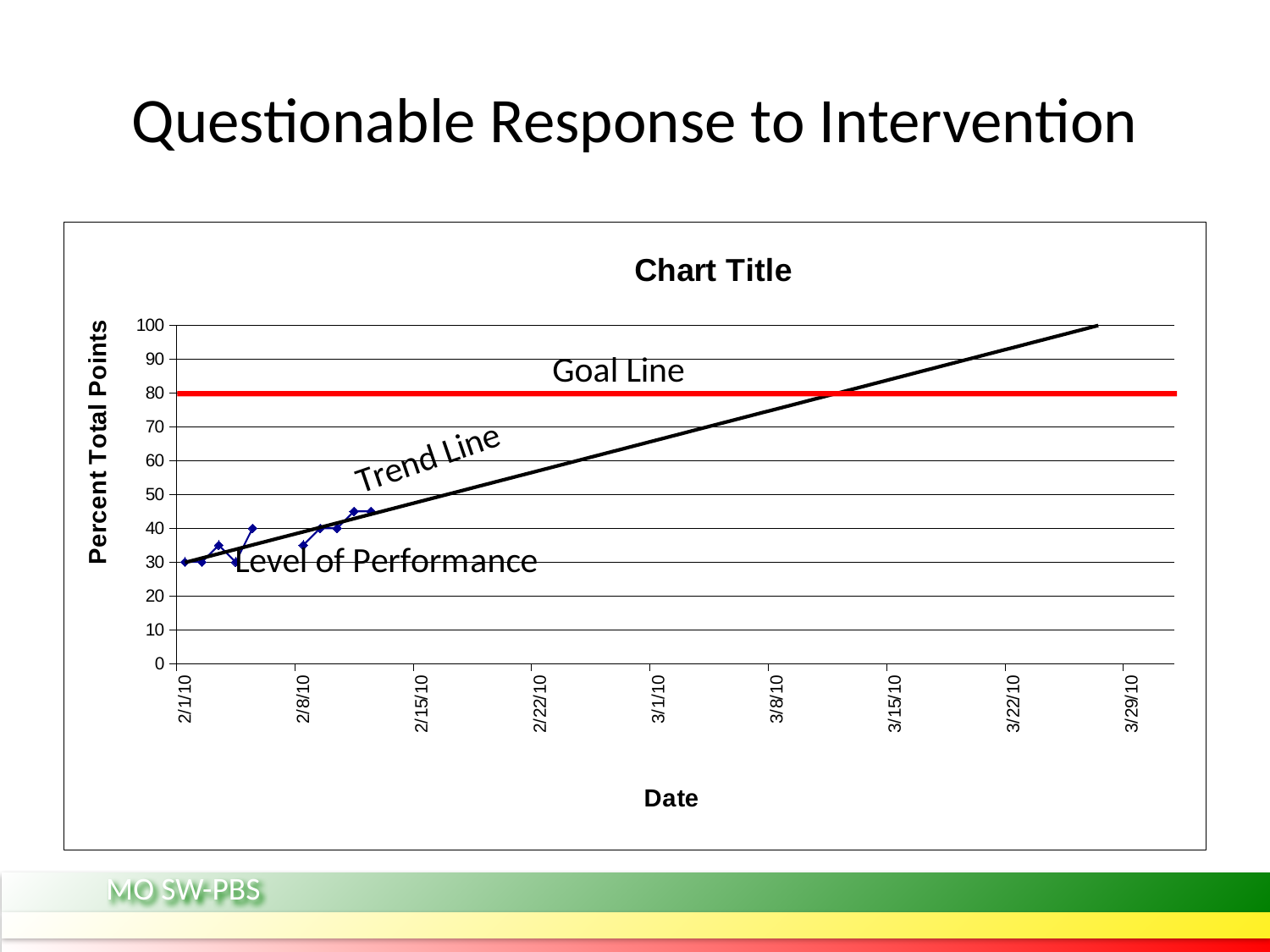
Does the Trend Line cross the Goal Line before or after 3/8/10? After At what value on the y-axis is the Goal Line drawn? 80 Is the Trend Line value on 3/1/10 greater or less than 60? greater What value does the Trend Line reach at its right-hand end? 100 What is the Level of Performance value on 2/1/10? 30 On 2/1/10, which is higher: the Goal Line or the Level of Performance? Goal Line What is the title of the y-axis? Percent Total Points How many date labels are shown on the x-axis? 9 What is the title of the x-axis? Date What kind of chart is shown on the slide? Line chart Is the Level of Performance value on 2/8/10 greater or less than 40? less Does the Trend Line rise or fall as the date moves from left to right? Rises